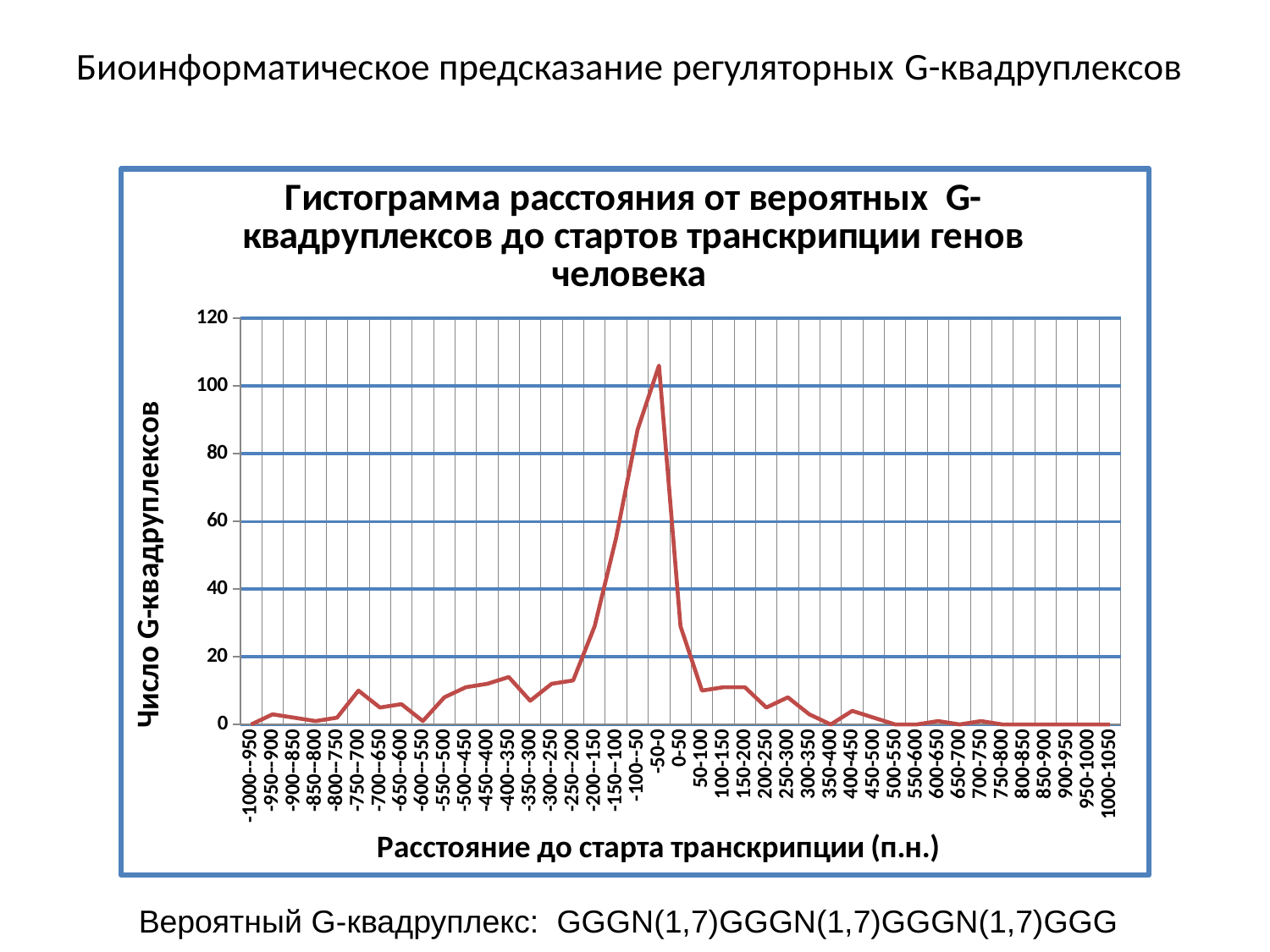
What is the label of the vertical axis? Число G-квадруплексов What kind of chart is shown on the slide? line chart Which distance bin has the highest number of G-quadruplexes? -50-0 How many distance bins are shown on the x axis? 41 Is the value for the 50-100 bin greater or less than 20? less Is the value for the 0-50 bin greater or less than 40? less Is the value for the -50-0 bin greater or less than 100? greater What is the title of the chart? Гистограмма расстояния от вероятных G-квадруплексов до стартов транскрипции генов человека Which bin has the larger value, -50-0 or 0-50? -50-0 Do the values rise or fall from the -250--200 bin to the -50-0 bin? rise